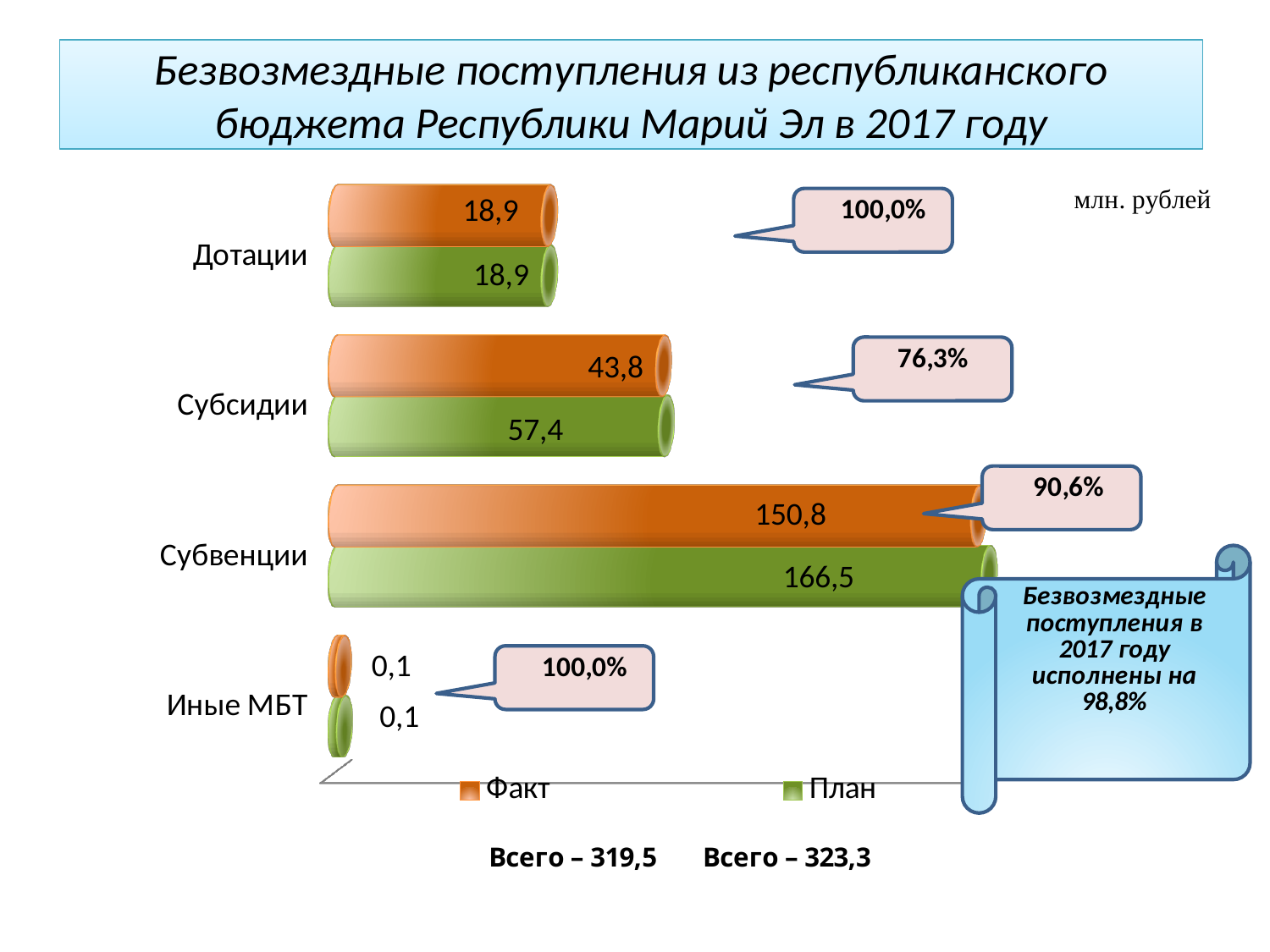
Which category has the highest План value? Субвенции What kind of chart is shown on the slide? Bar chart What is the Факт value for Дотации? 18,9 How many series does the legend list? 2 What is the difference between the План and Факт values for Субвенции? 15,7 What is the План value for Иные МБТ? 0,1 What is the План value for Субсидии? 57,4 Which category has the lowest Факт value? Иные МБТ Which is larger for Субсидии, the Факт value or the План value? План How many categories are shown in the chart? 4 What is the difference between the План and Факт values for Субсидии? 13,6 What is the Факт value for Субвенции? 150,8